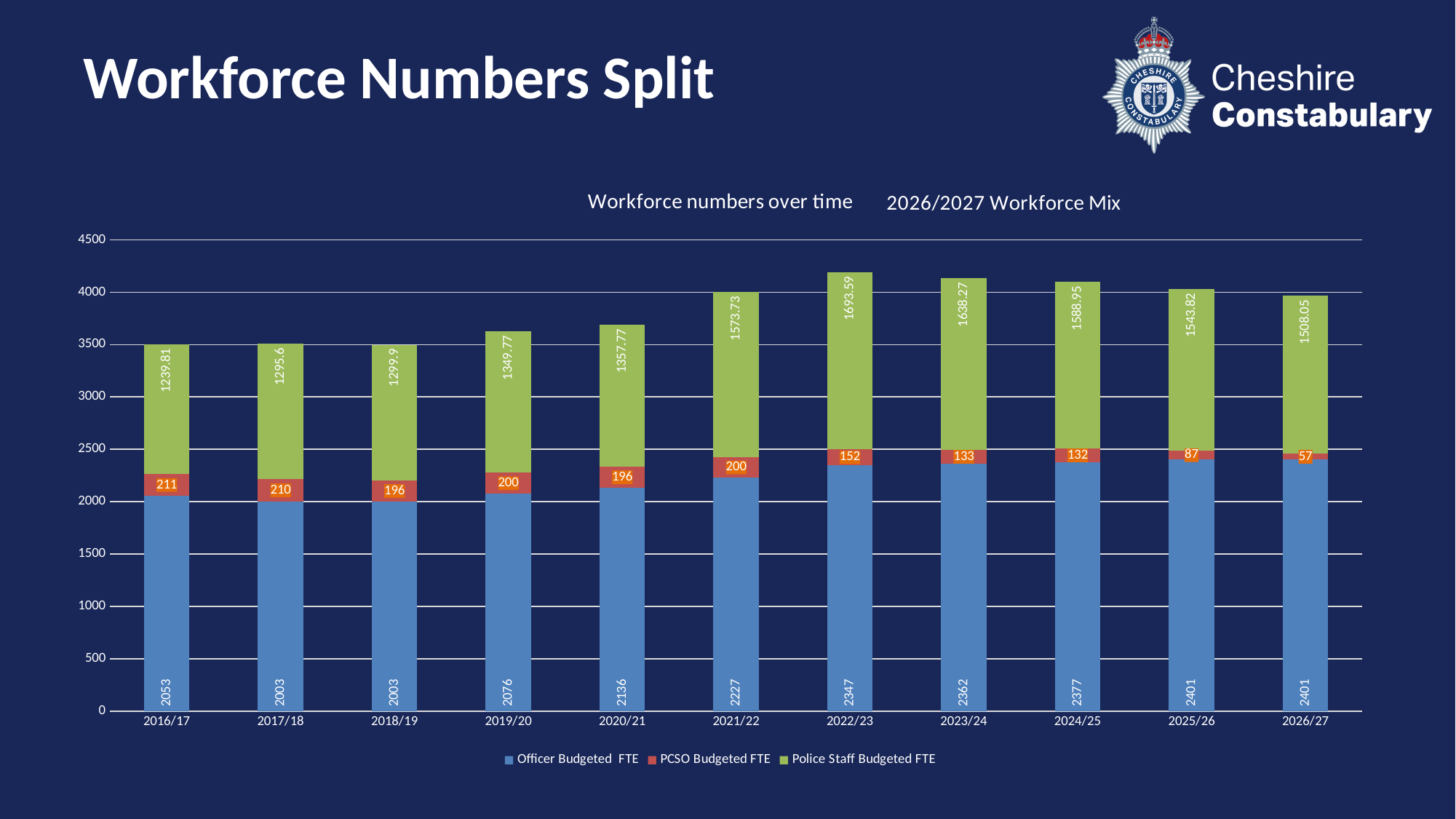
Does the Officer Budgeted FTE generally rise or fall from 2018/19 to 2026/27? Rise What is the PCSO Budgeted FTE value for 2026/27? 57 What kind of chart is shown? Stacked bar chart How many series does the legend list? 3 Which year has the highest Police Staff Budgeted FTE? 2022/23 What is the Police Staff Budgeted FTE value for 2022/23? 1693.59 What is the Officer Budgeted FTE value for 2016/17? 2053 Which is larger, the PCSO Budgeted FTE in 2016/17 or in 2025/26? 2016/17 How many years are shown on the x axis? 11 What is the difference between the Officer Budgeted FTE in 2026/27 and in 2016/17? 348 What is the total of the stacked bar for 2022/23? 4192.59 Which year has the lowest PCSO Budgeted FTE? 2026/27